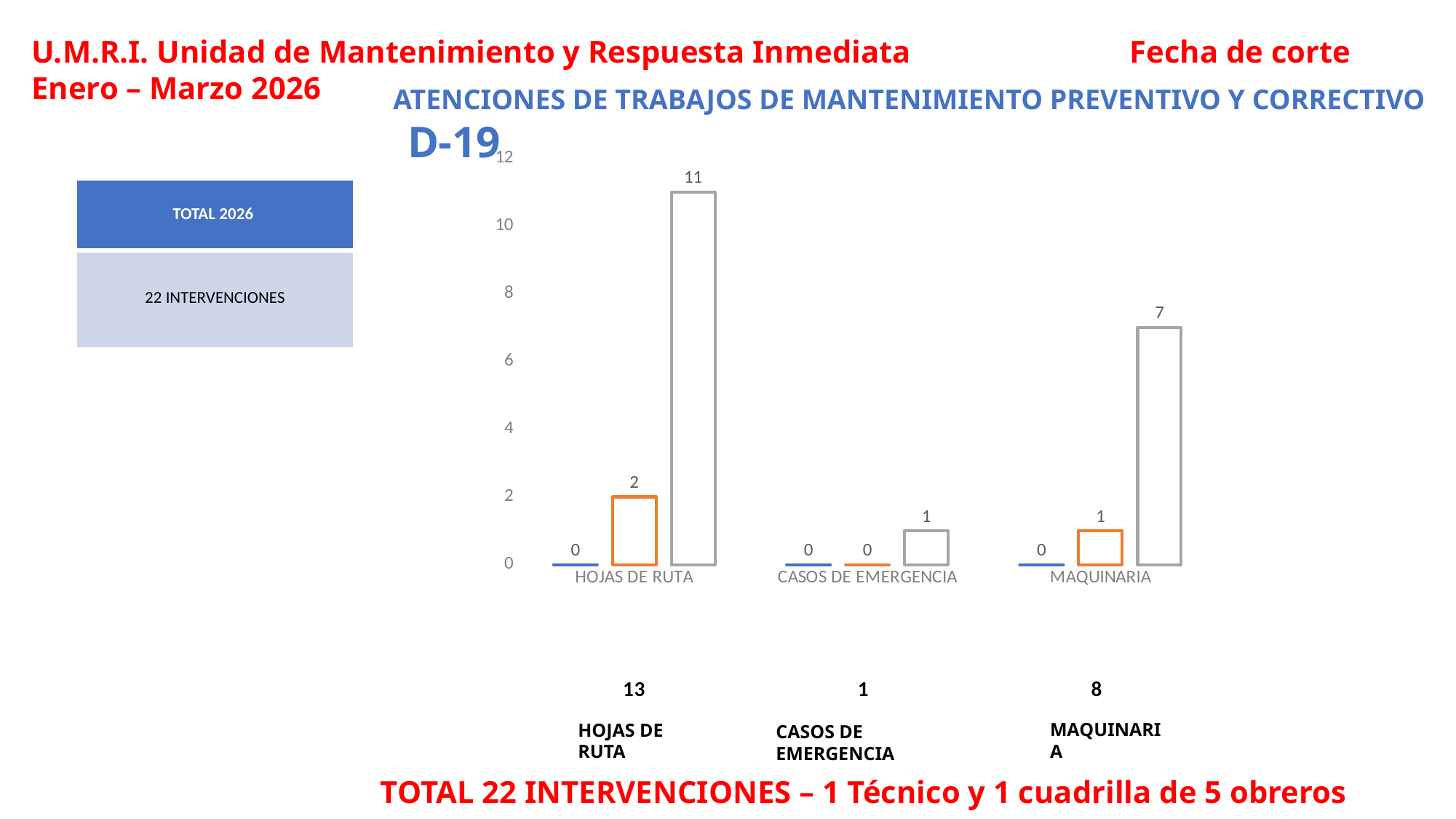
What is the value of the gray bar for HOJAS DE RUTA? 11 What is the value of the gray bar for CASOS DE EMERGENCIA? 1 Which category has the highest gray bar? HOJAS DE RUTA Which is larger: the orange bar for HOJAS DE RUTA or the orange bar for MAQUINARIA? HOJAS DE RUTA What is the value of the orange bar for HOJAS DE RUTA? 2 Which category has the lowest gray bar? CASOS DE EMERGENCIA How many categories are shown on the x axis of the chart? 3 What is the difference between the gray bar for HOJAS DE RUTA and the gray bar for MAQUINARIA? 4 What is the value of the orange bar for MAQUINARIA? 1 What is the title of the chart? ATENCIONES DE TRABAJOS DE MANTENIMIENTO PREVENTIVO Y CORRECTIVO D-19 What is the value of the gray bar for MAQUINARIA? 7 What kind of chart is shown on the slide? Bar chart